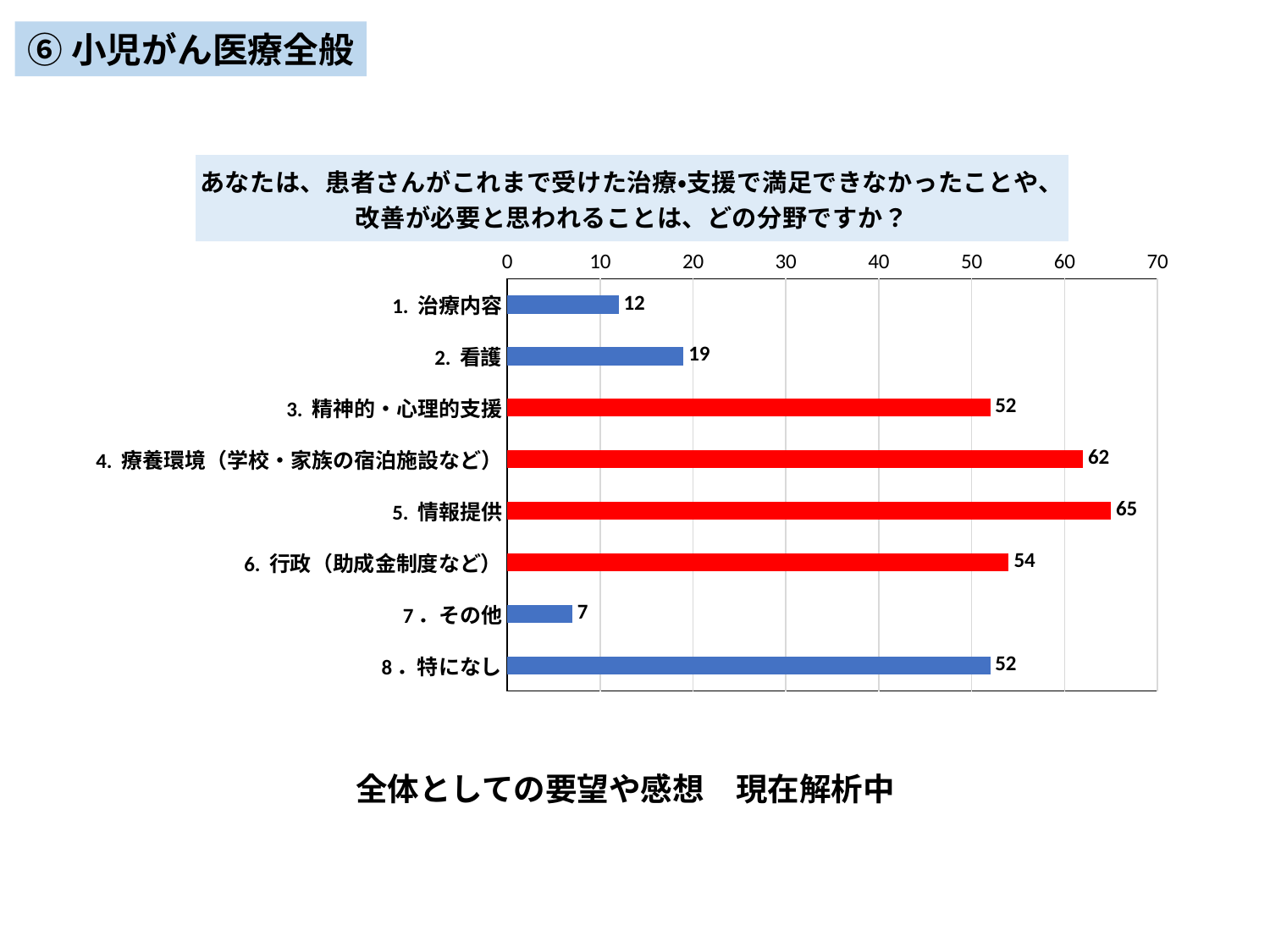
How many bars are coloured red? 4 How many categories are shown in the chart? 8 Which is larger, the value for 4. 療養環境（学校・家族の宿泊施設など） or the value for 6. 行政（助成金制度など）? 4. 療養環境（学校・家族の宿泊施設など） What is the value for 2. 看護? 19 Which category has the highest value? 5. 情報提供 What is the value for 4. 療養環境（学校・家族の宿泊施設など）? 62 What is the difference between the values for 5. 情報提供 and 1. 治療内容? 53 What kind of chart is shown on the slide? bar chart Which category has the lowest value? 7. その他 What is the value for 5. 情報提供? 65 Is the value for 8. 特になし greater or less than 40? greater What is the difference between the values for 6. 行政（助成金制度など） and 3. 精神的・心理的支援? 2